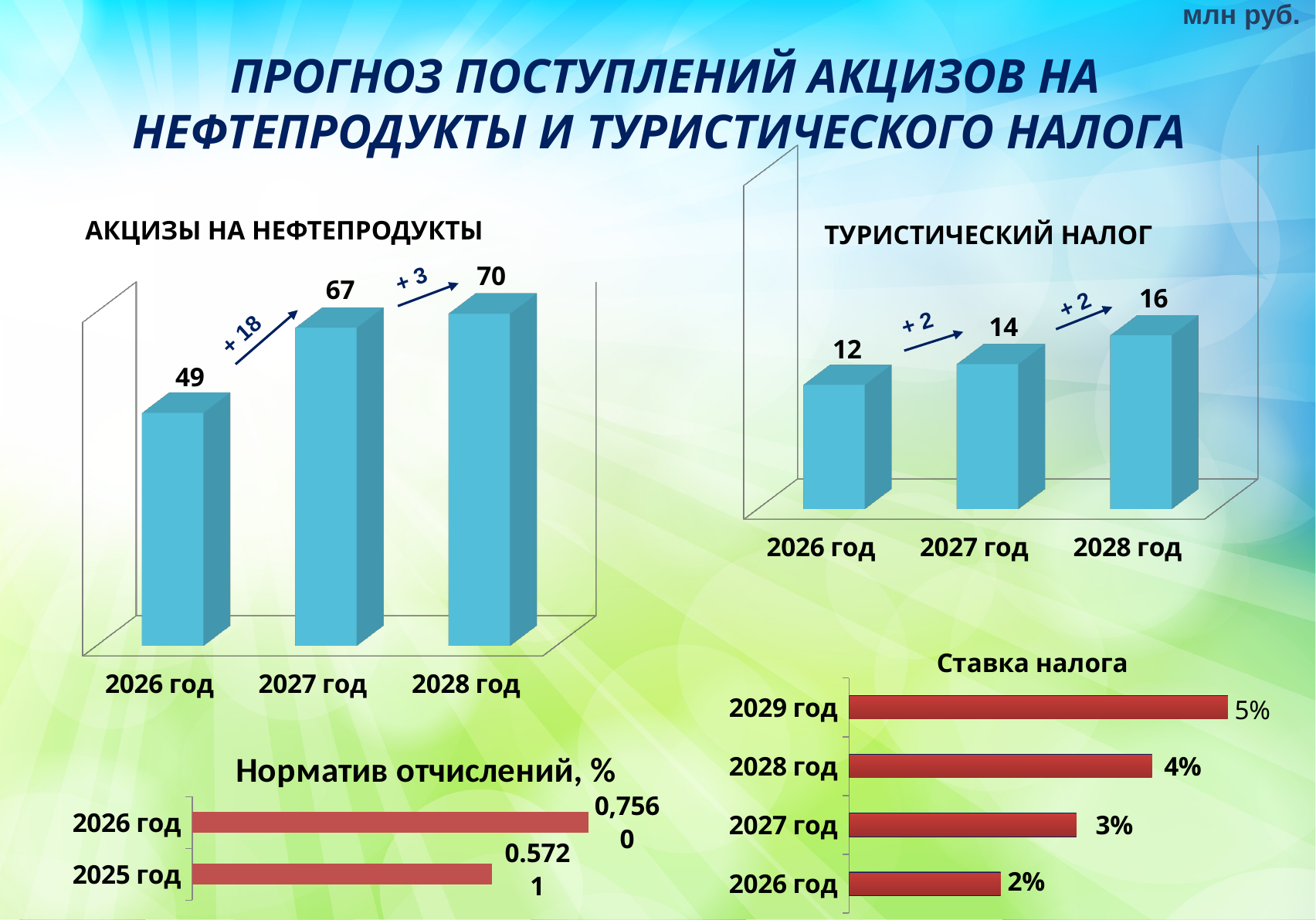
In the chart titled 'Ставка налога', what is the value for 2027 год? 3% In the chart titled 'ТУРИСТИЧЕСКИЙ НАЛОГ', what is the value for 2028 год? 16 What kind of chart is the one titled 'ТУРИСТИЧЕСКИЙ НАЛОГ'? bar chart In the chart titled 'ТУРИСТИЧЕСКИЙ НАЛОГ', what is the difference between the values for 2027 год and 2026 год? 2 In the chart titled 'АКЦИЗЫ НА НЕФТЕПРОДУКТЫ', which year has the lowest value? 2026 год In the chart titled 'ТУРИСТИЧЕСКИЙ НАЛОГ', how many years are plotted? 3 In the chart titled 'АКЦИЗЫ НА НЕФТЕПРОДУКТЫ', what is the difference between the values for 2028 год and 2026 год? 21 In the chart titled 'АКЦИЗЫ НА НЕФТЕПРОДУКТЫ', do the values rise or fall from 2026 год to 2028 год? rise In the chart titled 'АКЦИЗЫ НА НЕФТЕПРОДУКТЫ', what is the value for 2027 год? 67 In the chart titled 'Ставка налога', which year has the highest value? 2029 год In the chart titled 'Ставка налога', how many years are plotted? 4 In the chart titled 'Норматив отчислений, %', which year has the larger value, 2026 год or 2025 год? 2026 год